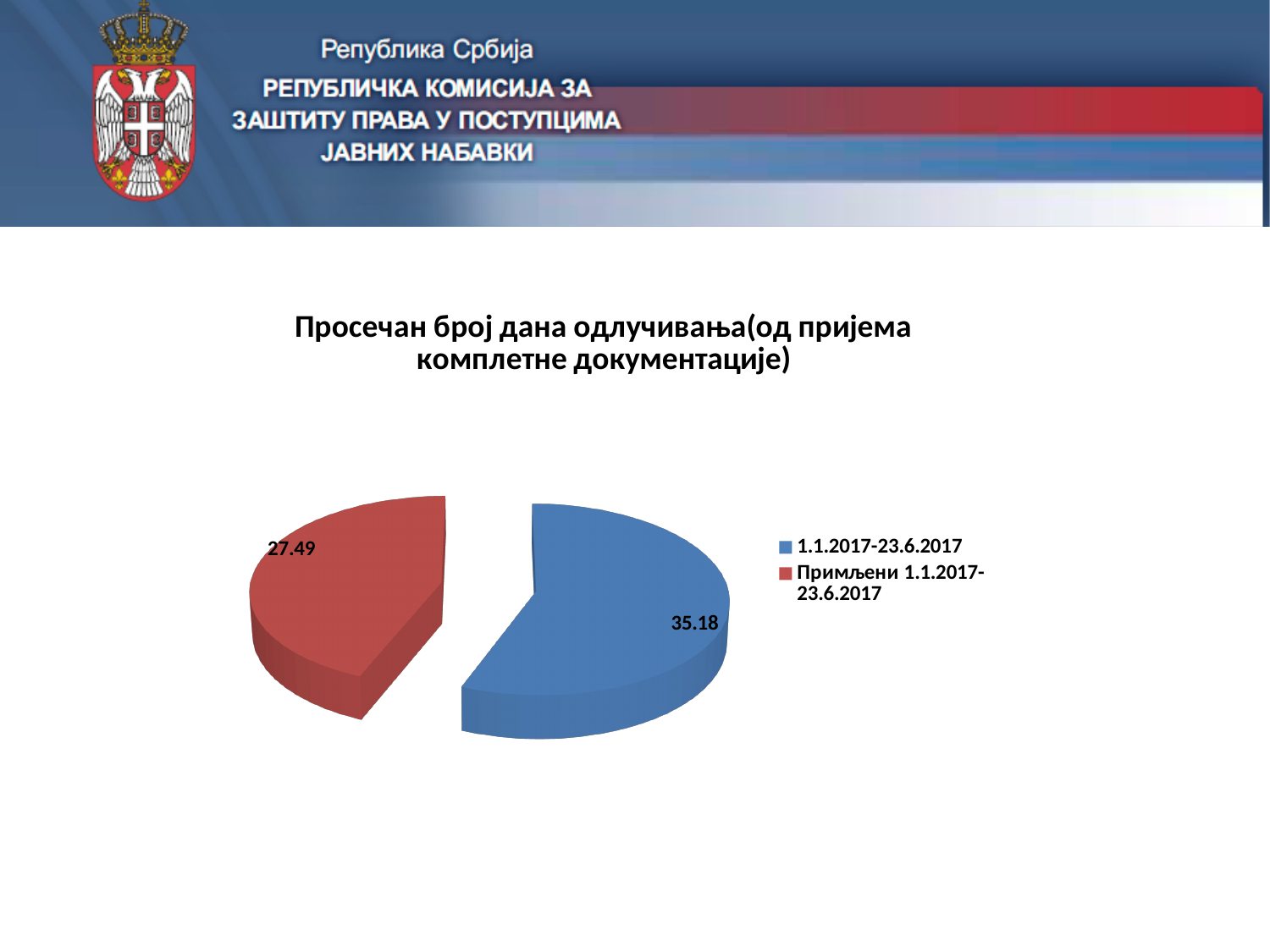
What is the value for the slice labelled 1.1.2017-23.6.2017? 35.18 Which is larger: the value for 1.1.2017-23.6.2017 or the value for Примљени 1.1.2017-23.6.2017? 1.1.2017-23.6.2017 What is the title of the chart? Просечан број дана одлучивања(од пријема комплетне документације) What is the difference between the values 35.18 and 27.49 shown on the chart? 7.69 What kind of chart is shown on the slide? Pie chart What is the value for the slice labelled Примљени 1.1.2017-23.6.2017? 27.49 Which category has the highest value? 1.1.2017-23.6.2017 How many entries does the legend list? 2 How many slices does the pie chart have? 2 Which category has the lowest value? Примљени 1.1.2017-23.6.2017 What colour is the slice for Примљени 1.1.2017-23.6.2017? Red